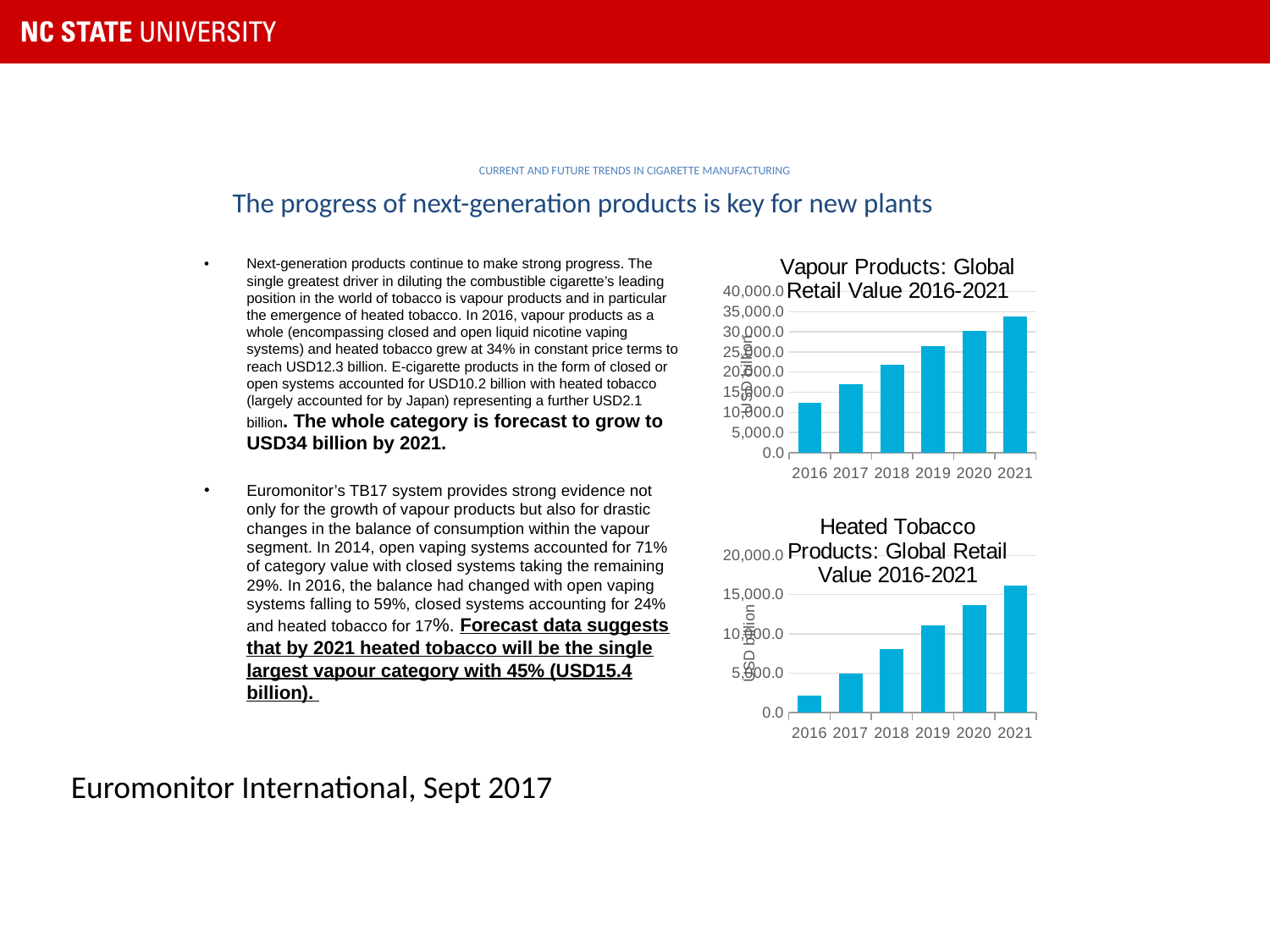
What type of chart is the 'Vapour Products: Global Retail Value 2016-2021' chart? bar chart In the 'Heated Tobacco Products: Global Retail Value 2016-2021' chart, is the value for 2021 greater or less than 15,000? greater What is the y-axis label on the 'Heated Tobacco Products: Global Retail Value 2016-2021' chart? USD billion In the 'Vapour Products: Global Retail Value 2016-2021' chart, how many years are plotted? 6 In the 'Vapour Products: Global Retail Value 2016-2021' chart, do the values rise or fall from 2016 to 2021? rise In the 'Vapour Products: Global Retail Value 2016-2021' chart, which year has the lowest value? 2016 In the 'Heated Tobacco Products: Global Retail Value 2016-2021' chart, which is larger, the value for 2018 or the value for 2020? 2020 In the 'Heated Tobacco Products: Global Retail Value 2016-2021' chart, is the value for 2016 greater or less than 5,000? less In the 'Vapour Products: Global Retail Value 2016-2021' chart, which year has the highest value? 2021 In the 'Vapour Products: Global Retail Value 2016-2021' chart, is the value for 2016 greater or less than 15,000? less In the 'Heated Tobacco Products: Global Retail Value 2016-2021' chart, which year has the lowest value? 2016